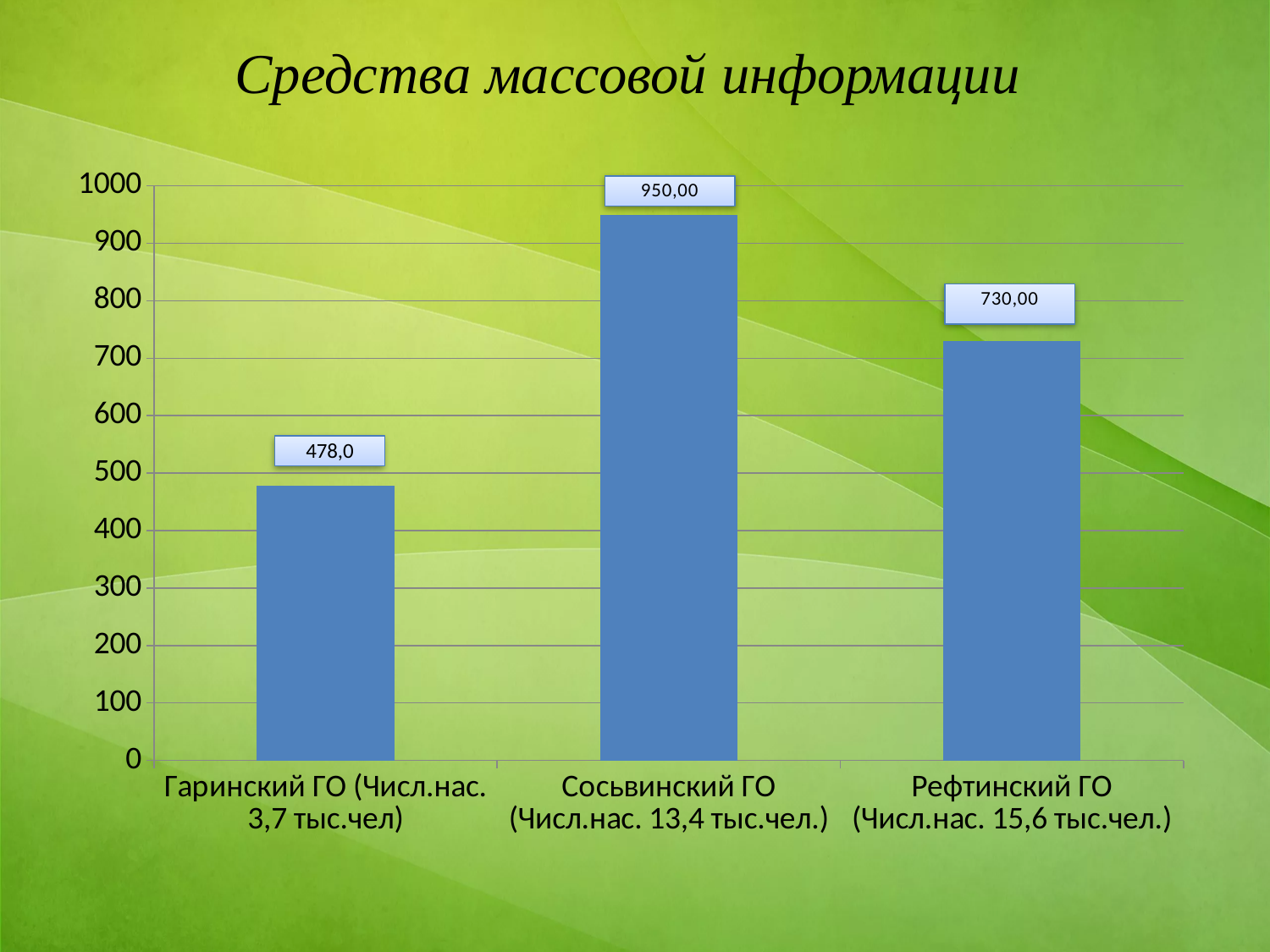
Is the value for Гаринский ГО greater or less than 500? less Which category has the lowest value? Гаринский ГО How many categories are shown in the chart? 3 What is the value for Рефтинский ГО? 730,00 What is the value for Сосьвинский ГО? 950,00 What is the difference between the values for Рефтинский ГО and Гаринский ГО? 252 Which category has the highest value? Сосьвинский ГО What is the value for Гаринский ГО? 478,0 What kind of chart is shown on the slide? bar chart Which is larger, the value for Рефтинский ГО or the value for Гаринский ГО? Рефтинский ГО What is the title of the slide? Средства массовой информации What is the difference between the values for Сосьвинский ГО and Рефтинский ГО? 220